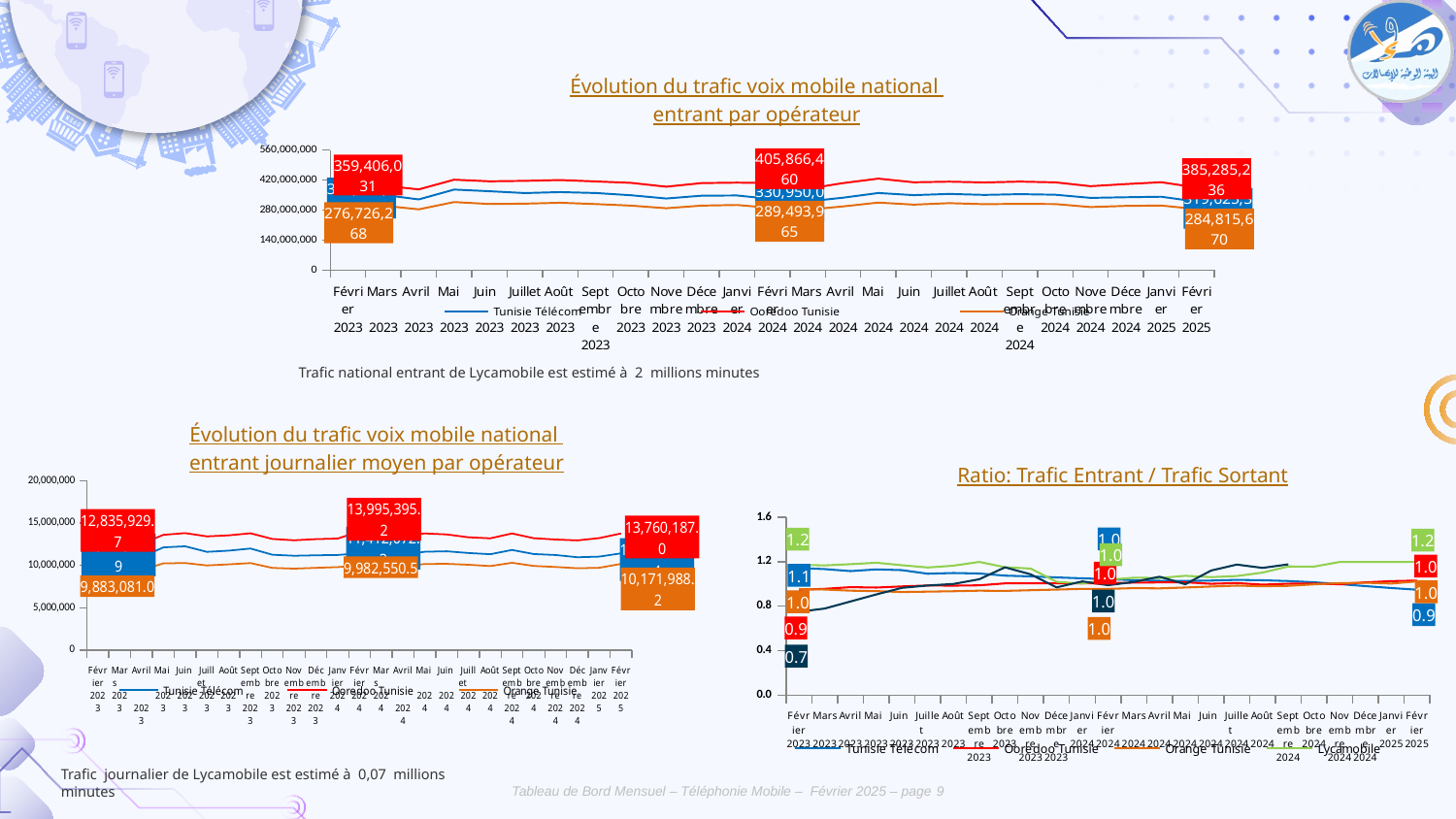
In the bottom-left chart 'Évolution du trafic voix mobile national entrant journalier moyen par opérateur', what is the value for Orange Tunisie in Février 2025? 10,171,988.2 In the bottom-right chart 'Ratio: Trafic Entrant / Trafic Sortant', how many series does the legend list? 4 In the top chart 'Évolution du trafic voix mobile national entrant par opérateur', what is the value for Orange Tunisie in Février 2024? 289,493,965 In the bottom-left chart 'Évolution du trafic voix mobile national entrant journalier moyen par opérateur', what is the value for Ooredoo Tunisie in Février 2024? 13,995,395.2 In the top chart 'Évolution du trafic voix mobile national entrant par opérateur', what is the value for Ooredoo Tunisie in Février 2023? 359,406,031 In the top chart 'Évolution du trafic voix mobile national entrant par opérateur', how many series does the legend list? 3 In the top chart 'Évolution du trafic voix mobile national entrant par opérateur', which operator has the highest traffic in Février 2025? Ooredoo Tunisie What kind of chart is the top chart titled 'Évolution du trafic voix mobile national entrant par opérateur'? line chart In the top chart 'Évolution du trafic voix mobile national entrant par opérateur', is the value for Tunisie Télécom in Février 2024 greater or less than 420,000,000? less In the top chart 'Évolution du trafic voix mobile national entrant par opérateur', what is the value for Ooredoo Tunisie in Février 2025? 385,285,236 In the bottom-left chart 'Évolution du trafic voix mobile national entrant journalier moyen par opérateur', which is larger in Février 2023: Ooredoo Tunisie or Orange Tunisie? Ooredoo Tunisie In the top chart 'Évolution du trafic voix mobile national entrant par opérateur', what is the difference between the Ooredoo Tunisie values in Février 2024 and Février 2025? 20,581,224